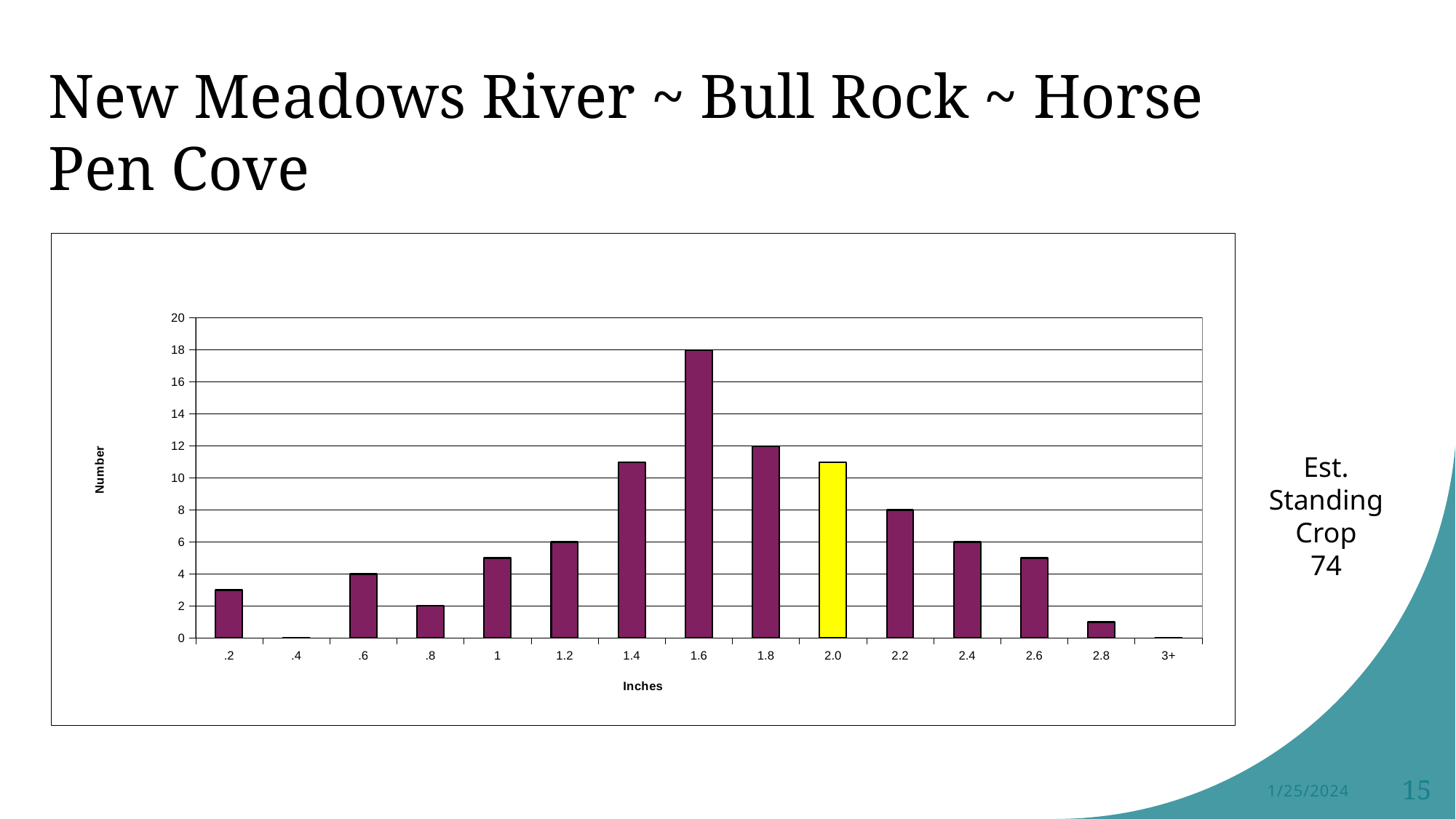
How many size categories are shown along the x axis of the chart? 15 What is the number for the 2.2 inch category? 8 What is the difference between the numbers for the 1.6 and 1.8 inch categories? 6 Is the value for the 2.8 inch category greater or less than 2? less Is the value for the 1.4 inch category greater or less than 10? greater What is the number for the 1.6 inch category? 18 Which size category has the highest number? 1.6 Which has a larger number, the 1.2 inch category or the 2.2 inch category? 2.2 What is the number for the 1.8 inch category? 12 Which size category is highlighted with a yellow bar? 2.0 What is the number for the .8 inch category? 2 What kind of chart is shown on the slide? bar chart